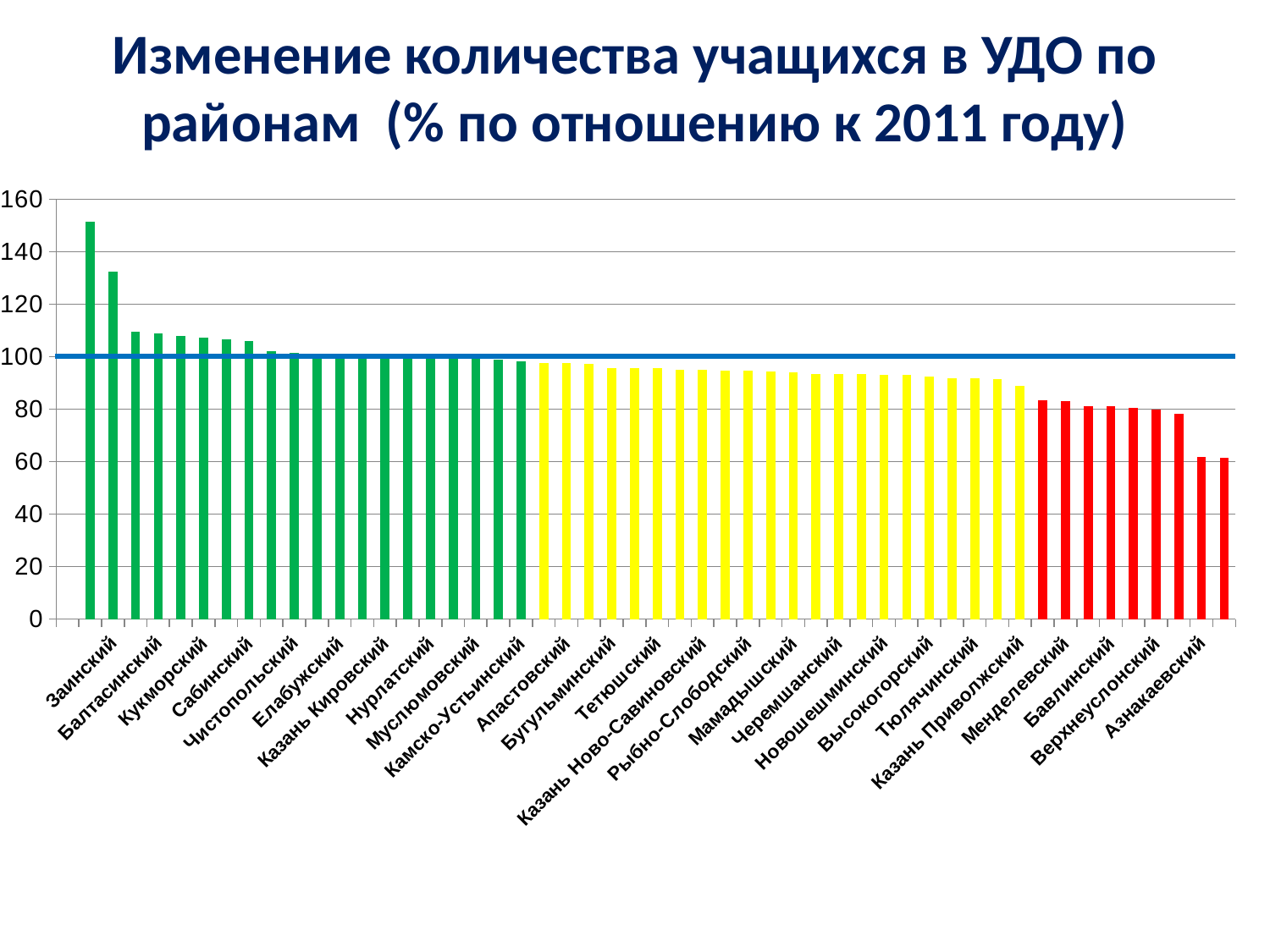
Is the value for Казань Приволжский greater or less than 100? less Is the value for Менделеевский greater or less than 100? less At what value is the horizontal reference line drawn across the chart? 100 Which is larger, the value for Кукморский or the value for Бавлинский? Кукморский Is the value for Заинский greater or less than 140? less Do the values rise or fall moving from left to right along the x axis? fall What kind of chart is shown on the slide? bar chart Which is larger, the value for Заинский or the value for Азнакаевский? Заинский